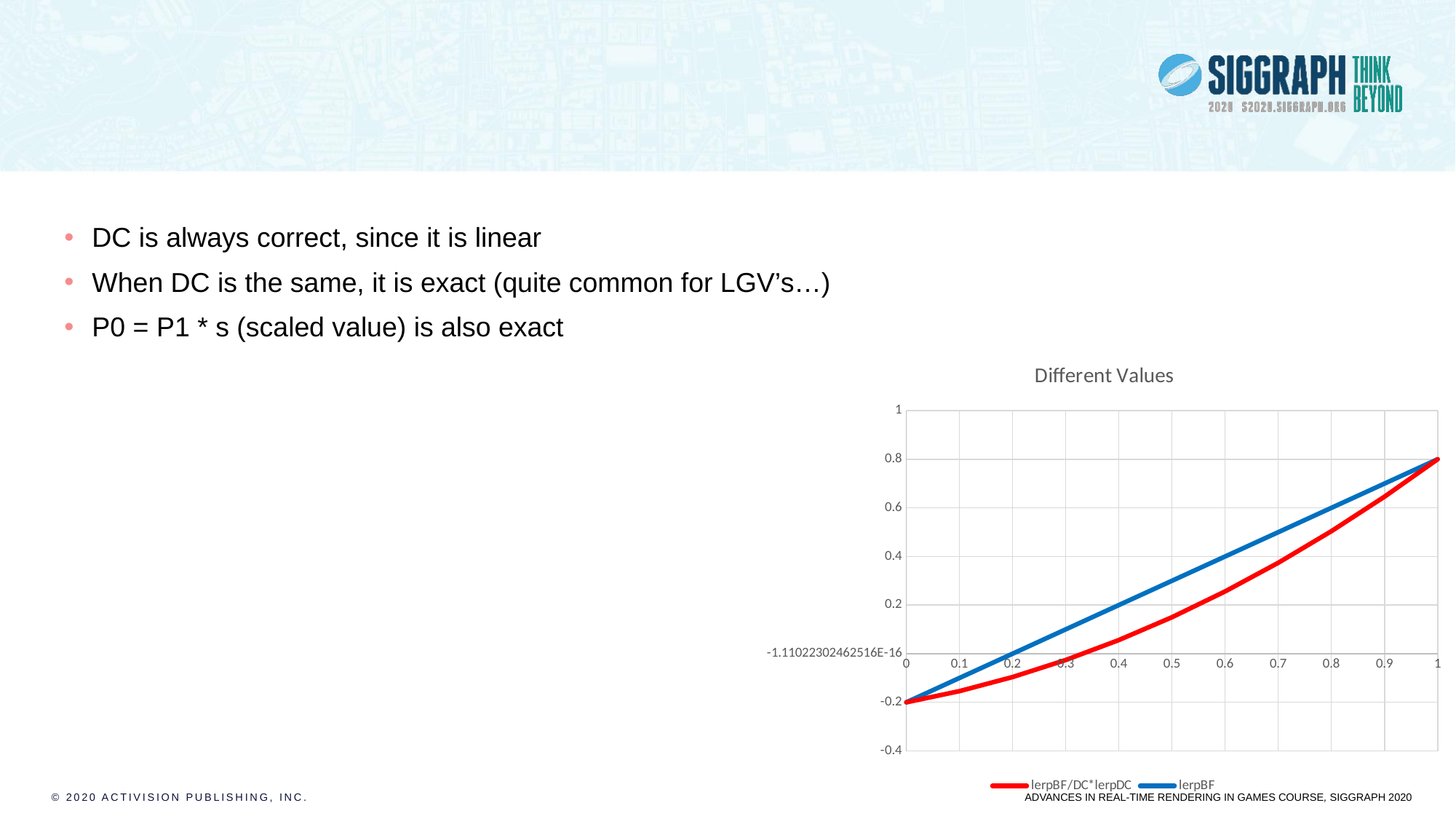
Is the value of lerpBF at x = 0.8 greater or less than 0.4? greater What kind of chart is shown on the slide? line chart What is the value of lerpBF at x = 0? -0.2 What is the value of lerpBF/DC*lerpDC at x = 1? 0.8 How many series does the chart legend list? 2 At x = 0.5, which series has the higher value, lerpBF or lerpBF/DC*lerpDC? lerpBF What is the value of lerpBF at x = 1? 0.8 What is the title of the chart? Different Values Is the value of lerpBF/DC*lerpDC at x = 0.5 greater or less than 0.2? less Which series is drawn in red? lerpBF/DC*lerpDC Do the values of lerpBF rise or fall as x increases from 0 to 1? rise Do the values of lerpBF/DC*lerpDC rise or fall as x increases from 0 to 1? rise